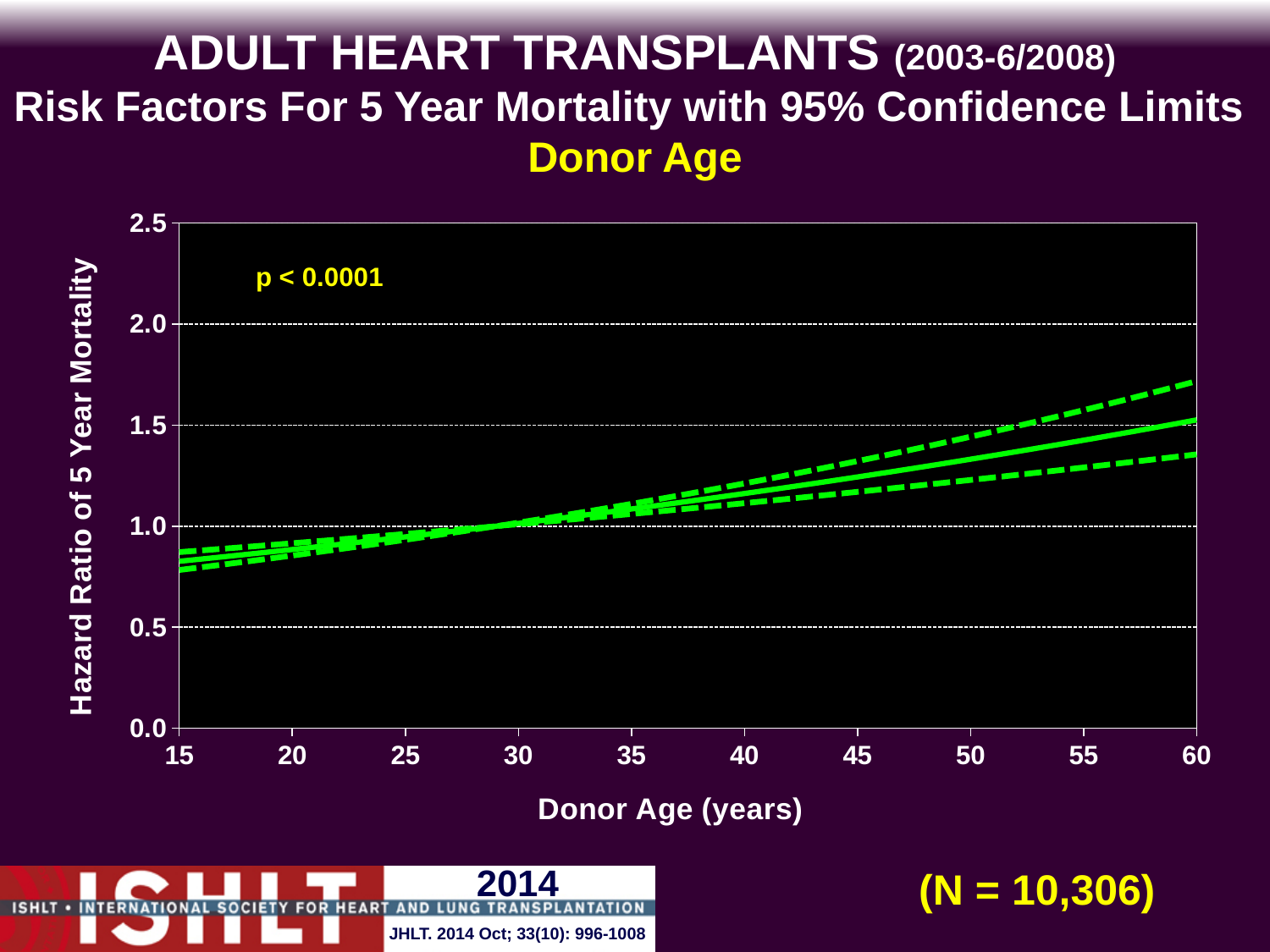
Is the upper 95% confidence limit at a donor age of 60 years greater or less than 1.5? greater Is the hazard ratio for a donor age of 45 years greater or less than 1.5? less Is the lower 95% confidence limit at a donor age of 60 years greater or less than 1.5? less Does the hazard ratio of 5 year mortality rise or fall as donor age increases from 15 to 60 years? rise How many lines are plotted on the chart? 3 What kind of chart is shown on the slide? line chart What p-value is printed on the chart? p < 0.0001 What is the label of the x axis? Donor Age (years)